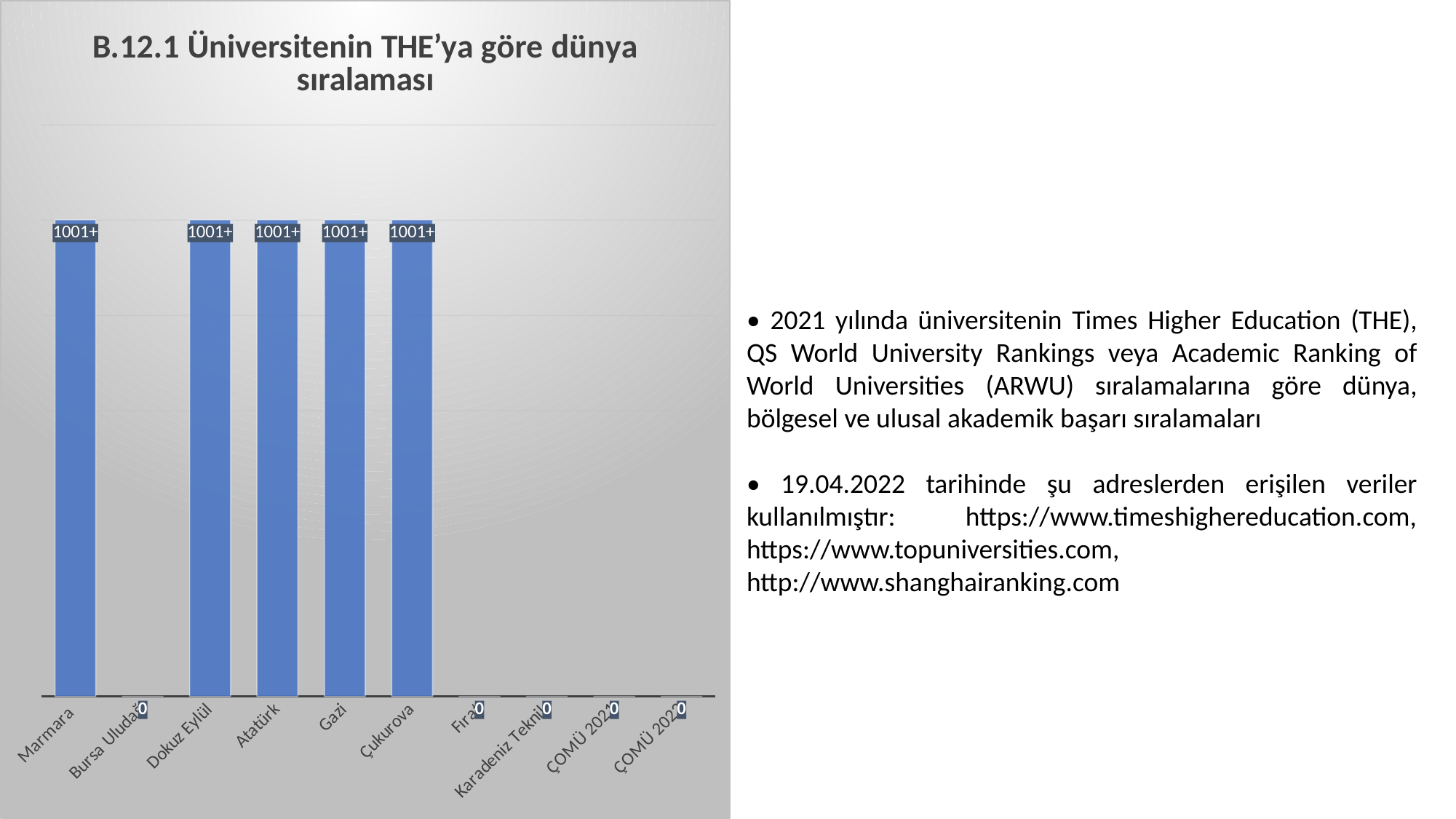
What is the value shown for Gazi? 1001+ What is the value shown for Karadeniz Teknik? 0 How many categories in the chart have a value of 1001+? 5 What is the value shown for ÇOMÜ 2021? 0 What type of chart is shown on the slide? bar chart What is the value shown for Bursa Uludağ? 0 How many categories are shown on the x axis of the chart? 10 What is the title of the chart? B.12.1 Üniversitenin THE'ya göre dünya sıralaması What is the value shown for Marmara? 1001+ Which has the larger value, Atatürk or Fırat? Atatürk What is the value shown for Çukurova? 1001+